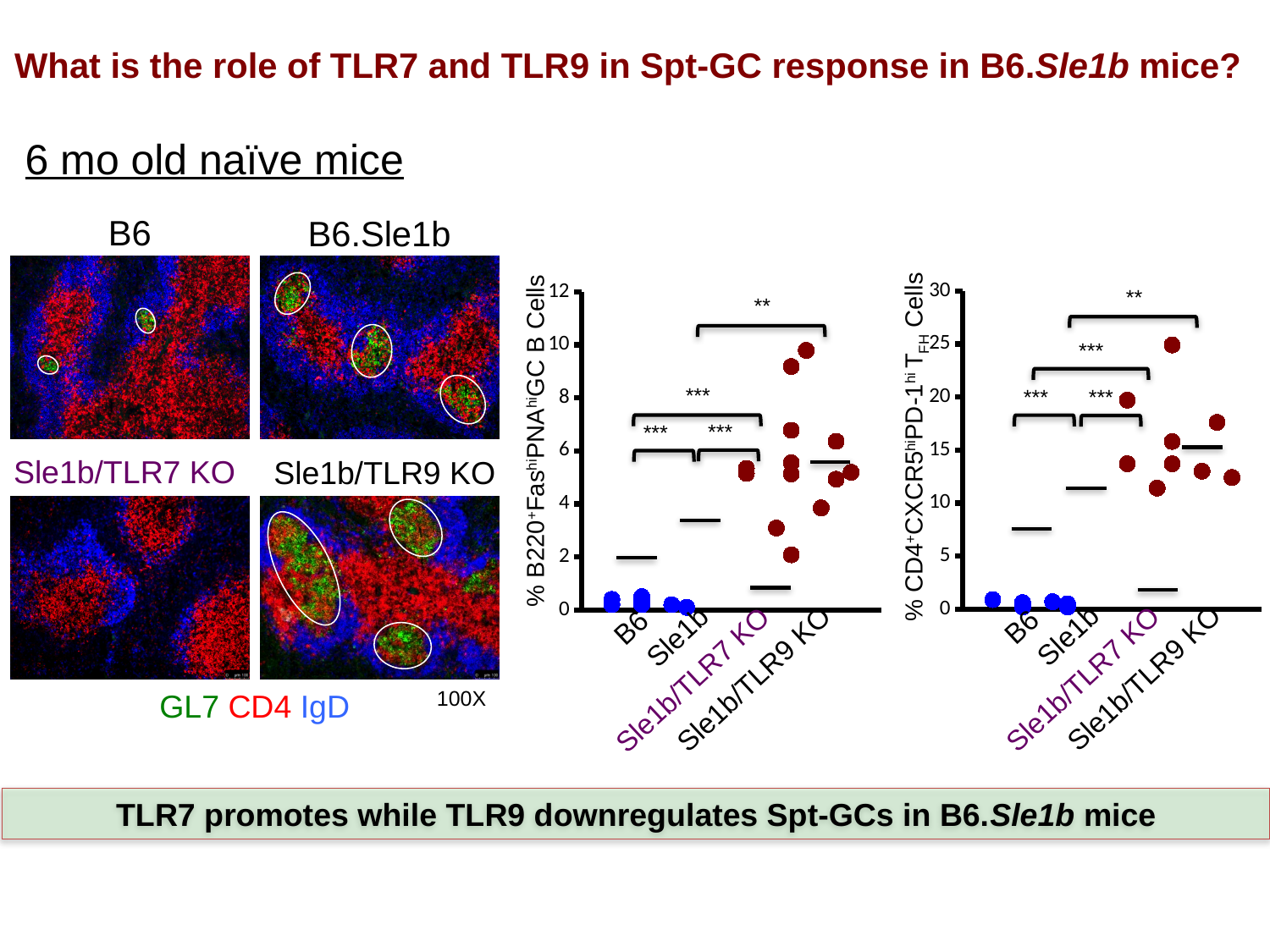
In the right chart (% CD4+CXCR5 hi PD-1 hi TFH Cells), how many groups are labelled on the x axis? 4 In the right chart (% CD4+CXCR5 hi PD-1 hi TFH Cells), is the highest point for Sle1b/TLR9 KO greater or less than 20? greater In the right chart (% CD4+CXCR5 hi PD-1 hi TFH Cells), which group contains the highest plotted point? Sle1b/TLR9 KO In the right chart, what colour are the points for the B6 and Sle1b groups? Blue In the left chart, what is the maximum value shown on the y axis? 12 In the left chart (% B220+Fas hi PNA hi GC B Cells), is the highest point for Sle1b/TLR9 KO greater or less than 8? greater In the right chart (% CD4+CXCR5 hi PD-1 hi TFH Cells), are the points for B6 greater or less than 5? less In the left chart (% B220+Fas hi PNA hi GC B Cells), how many groups are labelled on the x axis? 4 In the left chart (% B220+Fas hi PNA hi GC B Cells), which group contains the highest plotted point? Sle1b/TLR9 KO What kind of chart is the left chart showing % B220+Fas hi PNA hi GC B Cells? Scatter (dot) plot